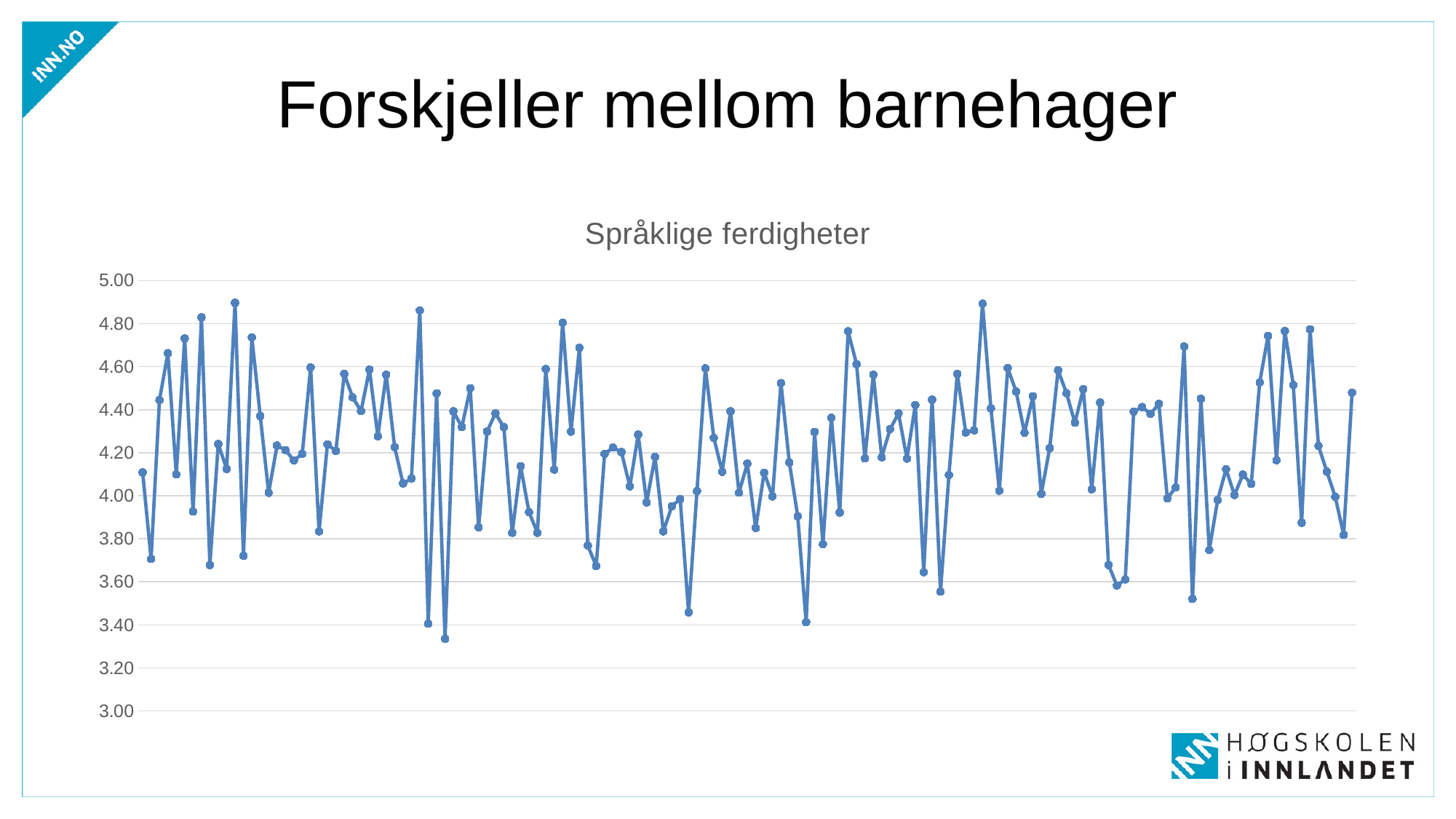
Is the lowest point on the line greater or less than 3.40? less Do the values in the chart show a steady rise or a steady fall from left to right? neither, they fluctuate with no clear trend Is the highest point on the line greater or less than 5.00? less What is the interval between the tick marks on the vertical axis of the chart? 0.20 Is the lowest point on the line greater or less than 3.20? greater What kind of chart is shown under the heading "Språklige ferdigheter"? line chart What is the title of the chart on the slide? Språklige ferdigheter